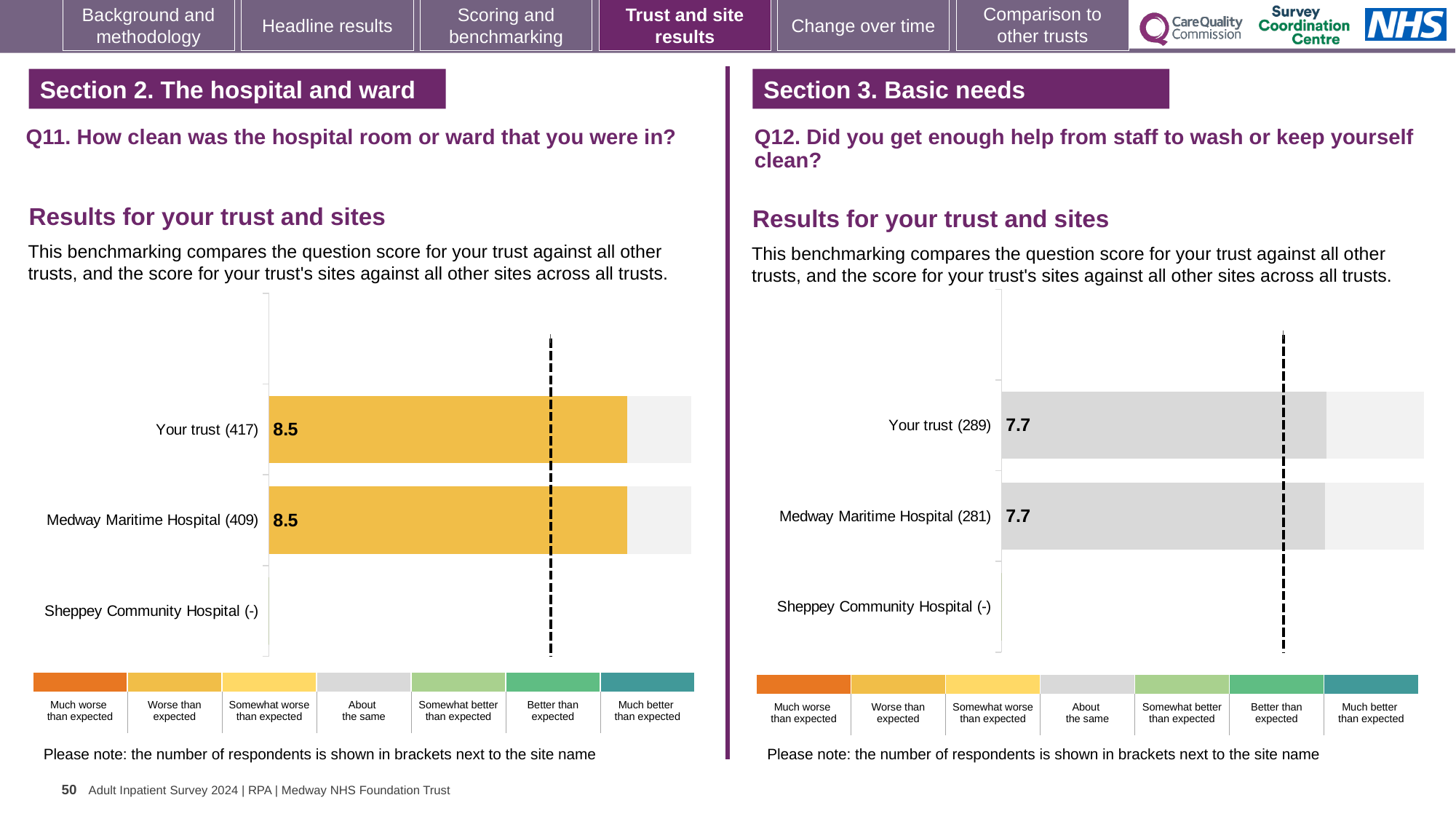
How many categories (rows) are listed on the Q11 chart on the left? 3 In the Q12 chart on the right, how many respondents are shown in brackets for Medway Maritime Hospital? 281 In the Q11 chart on the left, what is the score for Medway Maritime Hospital? 8.5 In the Q11 chart on the left, how many respondents are shown in brackets for Your trust? 417 In the Q12 chart on the right, which benchmark category does the colour of the Medway Maritime Hospital bar correspond to? About the same What kind of chart is the Q12 chart on the right? Bar chart In the Q12 chart on the right, what is the score for Medway Maritime Hospital? 7.7 In the Q12 chart on the right, what is the score for Your trust? 7.7 In the Q11 chart on the left, which benchmark category does the colour of the Your trust bar correspond to? Worse than expected In the Q11 chart on the left, what is the score for Your trust? 8.5 Is the score for Your trust in the Q11 chart on the left larger than the score for Your trust in the Q12 chart on the right? Yes In the Q11 chart on the left, what is the difference between the score for Your trust and the score for Medway Maritime Hospital? 0